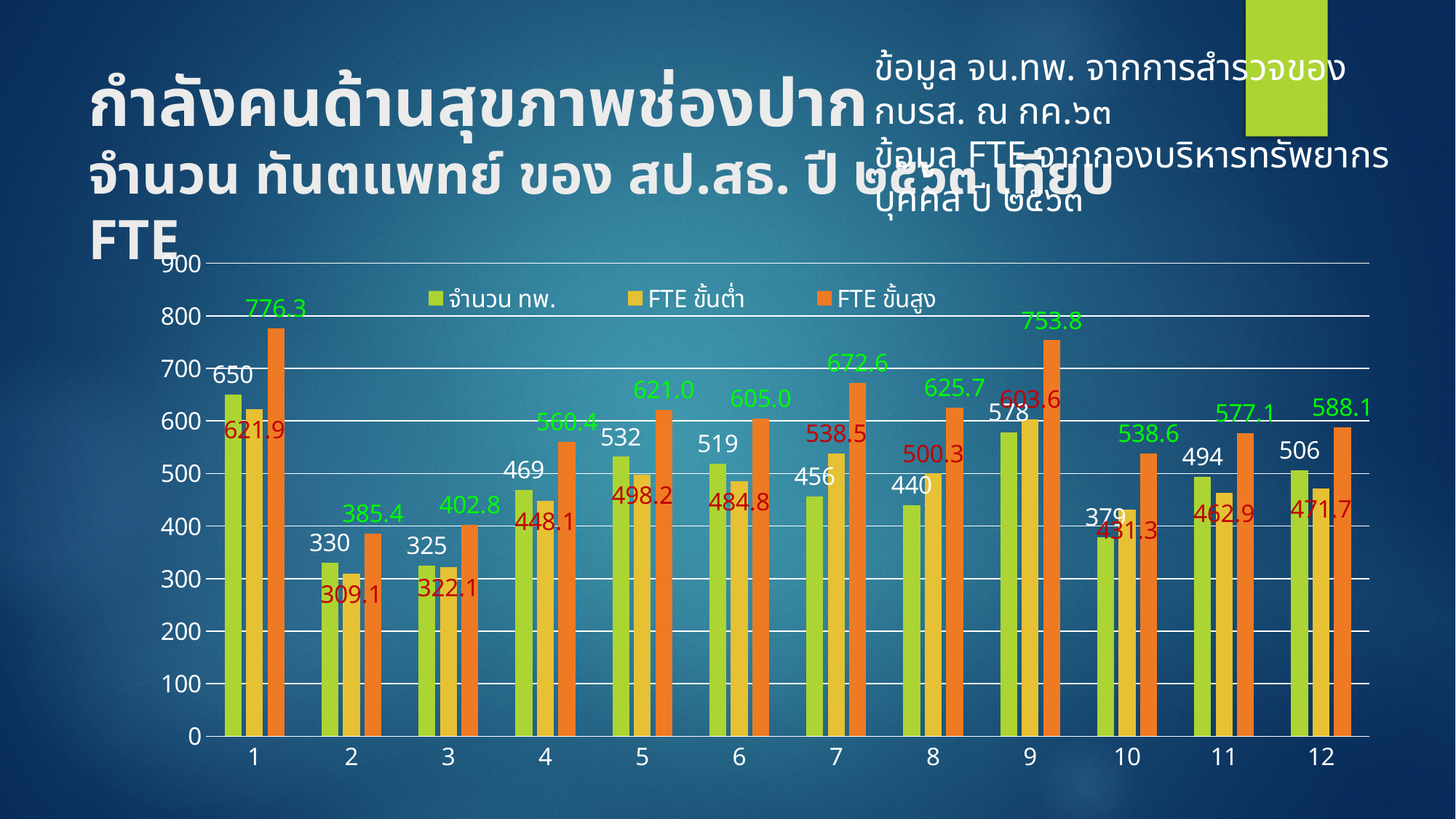
How many series does the legend list? 3 Which colour represents FTE ขั้นสูง in the chart? orange What is the difference between FTE ขั้นสูง and จำนวน ทพ. for category 1? 126.3 Is the FTE ขั้นสูง value for category 2 greater or less than 400? less What is the value of จำนวน ทพ. for category 1? 650 Which is larger for category 8: จำนวน ทพ. or FTE ขั้นต่ำ? FTE ขั้นต่ำ How many categories are shown on the x axis? 12 What is the value of FTE ขั้นสูง for category 9? 753.8 What is the value of FTE ขั้นต่ำ for category 7? 538.5 What kind of chart is shown on the slide? bar chart Which category has the lowest จำนวน ทพ. value? 3 Which category has the highest FTE ขั้นสูง value? 1